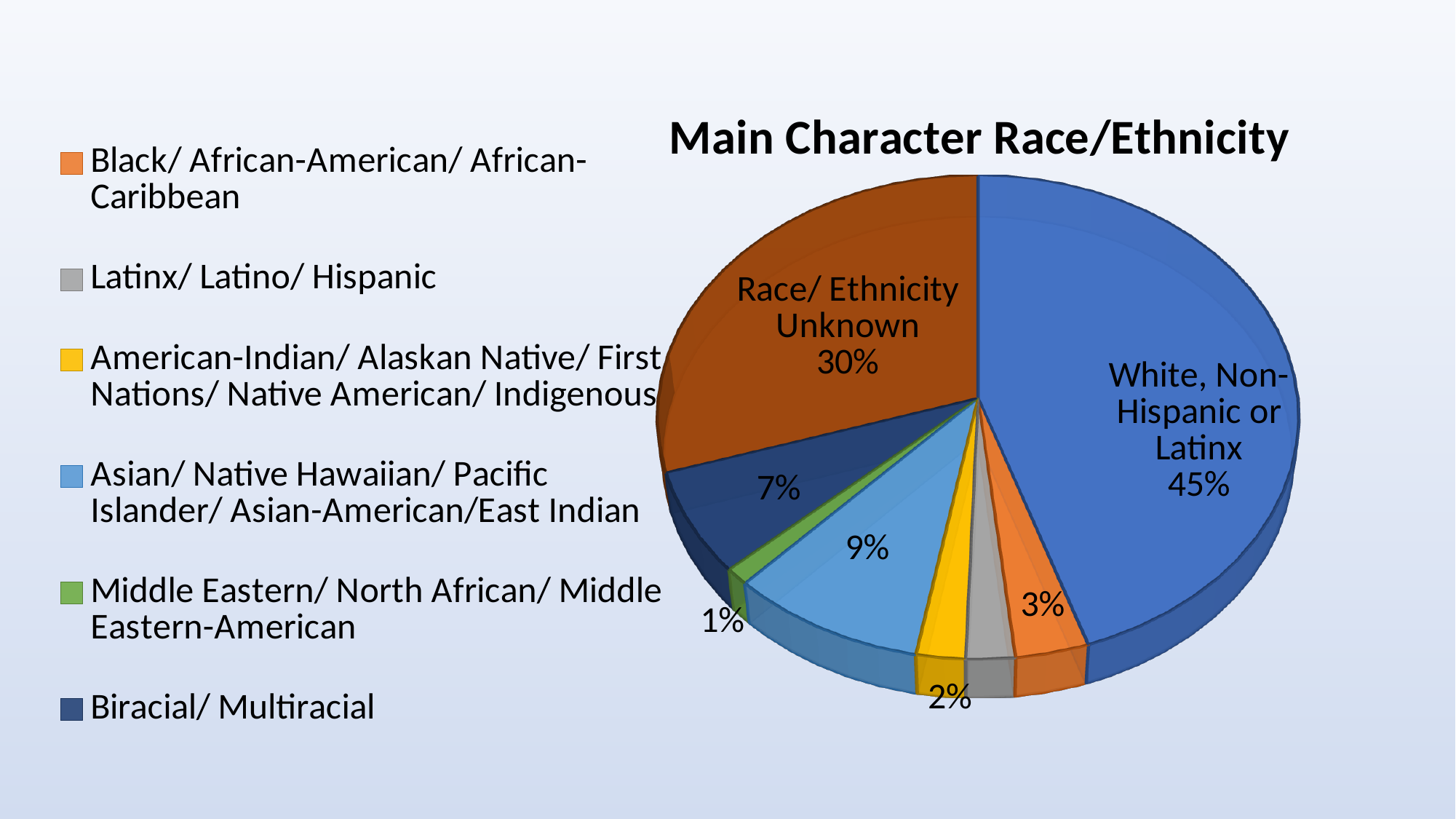
What percentage is shown for the Middle Eastern/ North African/ Middle Eastern-American slice? 1% What is the title of the chart? Main Character Race/Ethnicity What percentage of main characters are White, Non-Hispanic or Latinx? 45% Which category has the largest share of the pie? White, Non-Hispanic or Latinx What percentage is shown for the Black/ African-American/ African-Caribbean slice? 3% How many entries does the legend list? 6 What percentage is shown for the Asian/ Native Hawaiian/ Pacific Islander/ Asian-American/East Indian slice? 9% What kind of chart is shown on the slide? Pie chart How many percentage points larger is the White, Non-Hispanic or Latinx slice than the Race/Ethnicity Unknown slice? 15 percentage points What percentage is shown for the Biracial/ Multiracial slice? 7% What share of the pie is Race/Ethnicity Unknown? 30% Which category has the smallest share of the pie? Middle Eastern/ North African/ Middle Eastern-American